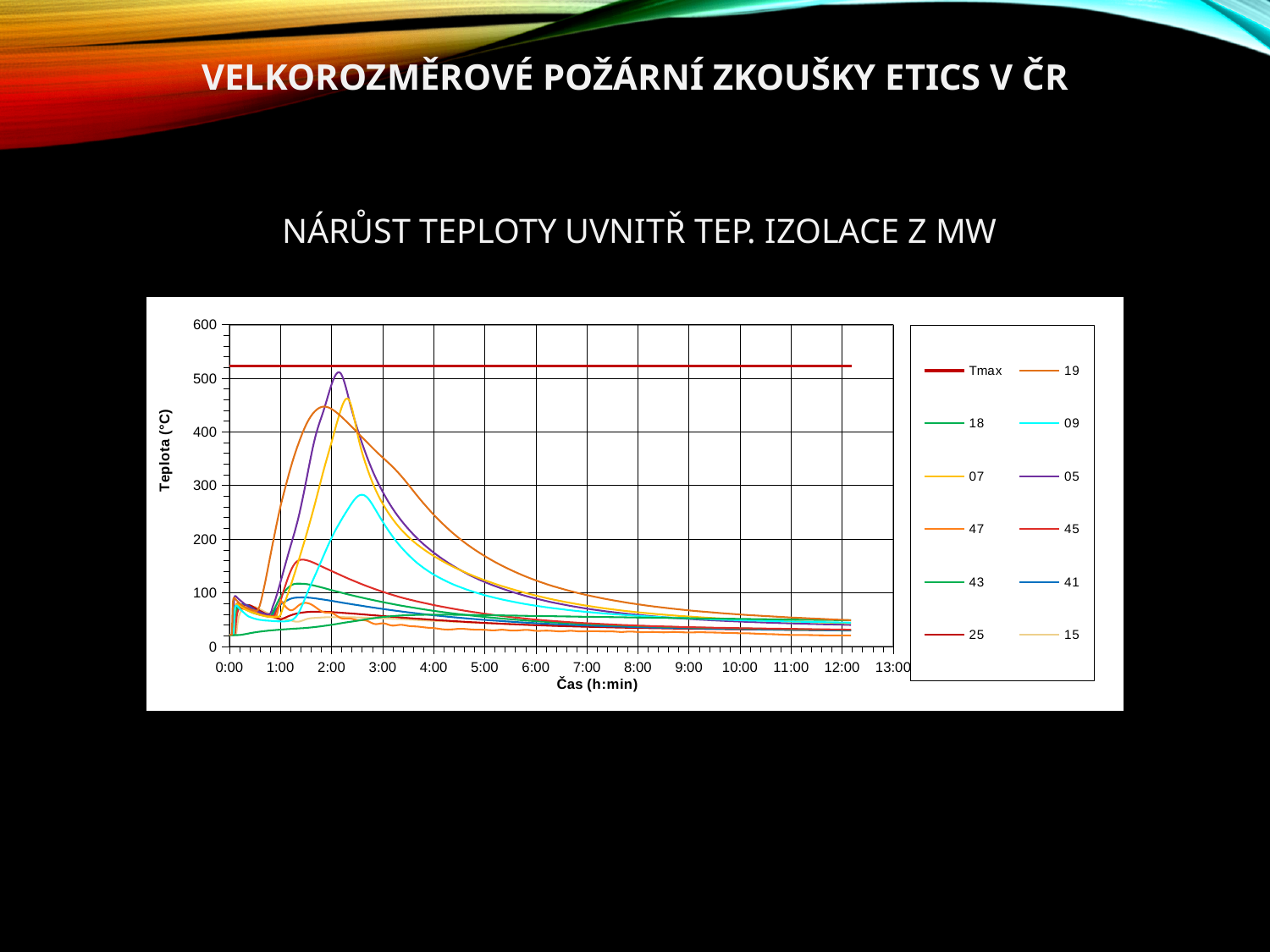
Which series has the higher peak temperature, 05 or 09? 05 What kind of chart is shown on the slide? line chart Is the value of the Tmax line greater or less than 500? greater Is the peak value of series 19 greater or less than 500? less Is the peak value of series 09 greater or less than 300? less What is the label of the horizontal axis of the chart? Čas (h:min) How many series does the chart legend list? 12 Excluding the Tmax line, which series reaches the highest peak temperature? 05 Does the Tmax line rise, fall, or stay constant over time? stays constant After reaching its peak at around 2:00, does series 05 rise or fall over the rest of the time axis? fall What is the label of the vertical axis of the chart? Teplota (°C)